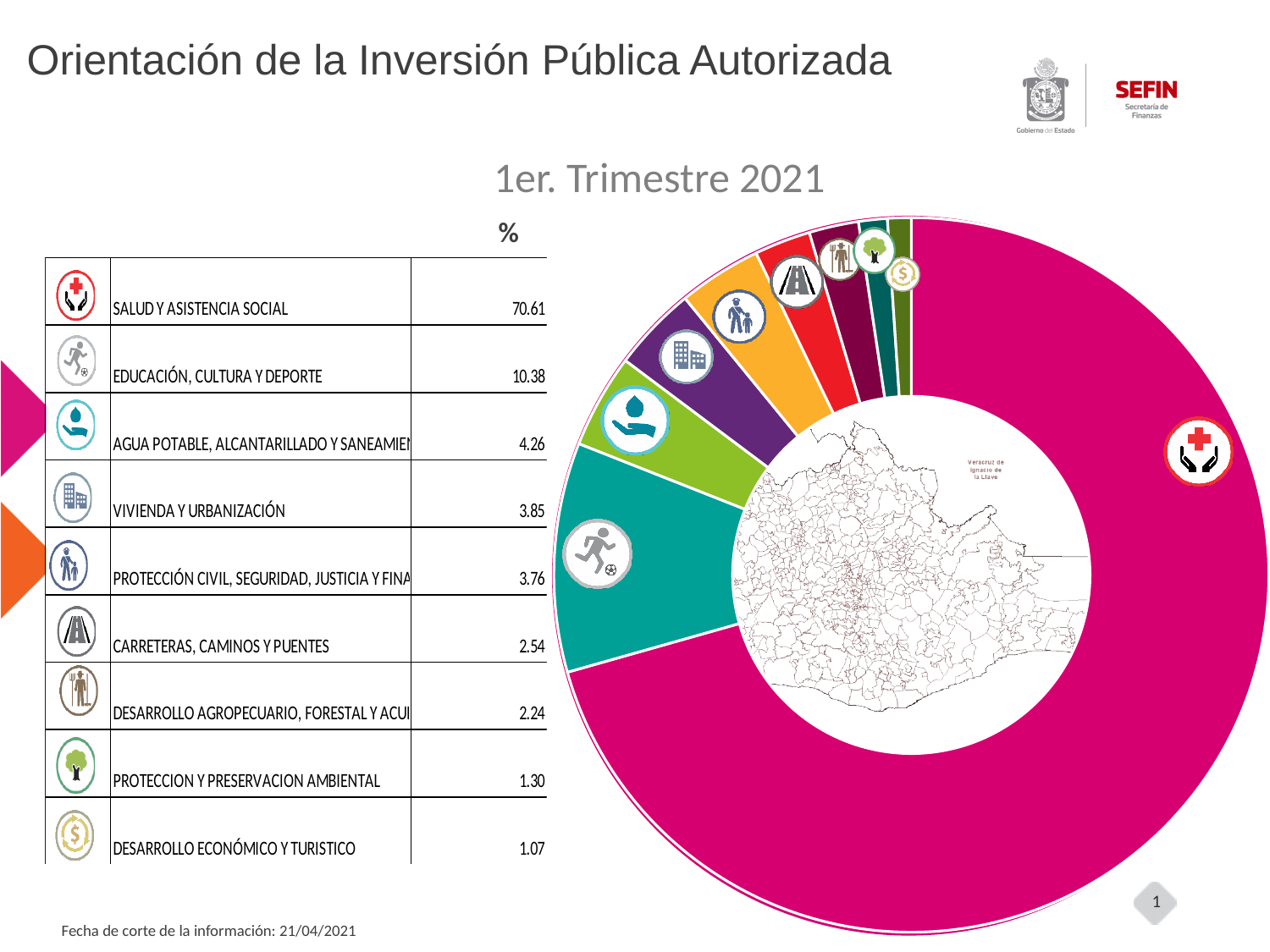
What percentage is shown for SALUD Y ASISTENCIA SOCIAL? 70.61% Which category has the largest share of the chart? SALUD Y ASISTENCIA SOCIAL What percentage is shown for CARRETERAS, CAMINOS Y PUENTES? 2.54% What is the difference in percentage points between SALUD Y ASISTENCIA SOCIAL and EDUCACIÓN, CULTURA Y DEPORTE? 60.23 What is the title shown above the chart? 1er. Trimestre 2021 What percentage is shown for VIVIENDA Y URBANIZACIÓN? 3.85% What type of chart is shown on the slide? Pie (donut) chart Which category has the smallest share of the chart? DESARROLLO ECONÓMICO Y TURISTICO Which has a larger share, CARRETERAS, CAMINOS Y PUENTES or VIVIENDA Y URBANIZACIÓN? VIVIENDA Y URBANIZACIÓN What percentage is shown for PROTECCION Y PRESERVACION AMBIENTAL? 1.30% What percentage is shown for EDUCACIÓN, CULTURA Y DEPORTE? 10.38% How many categories are listed in the table accompanying the chart? 9